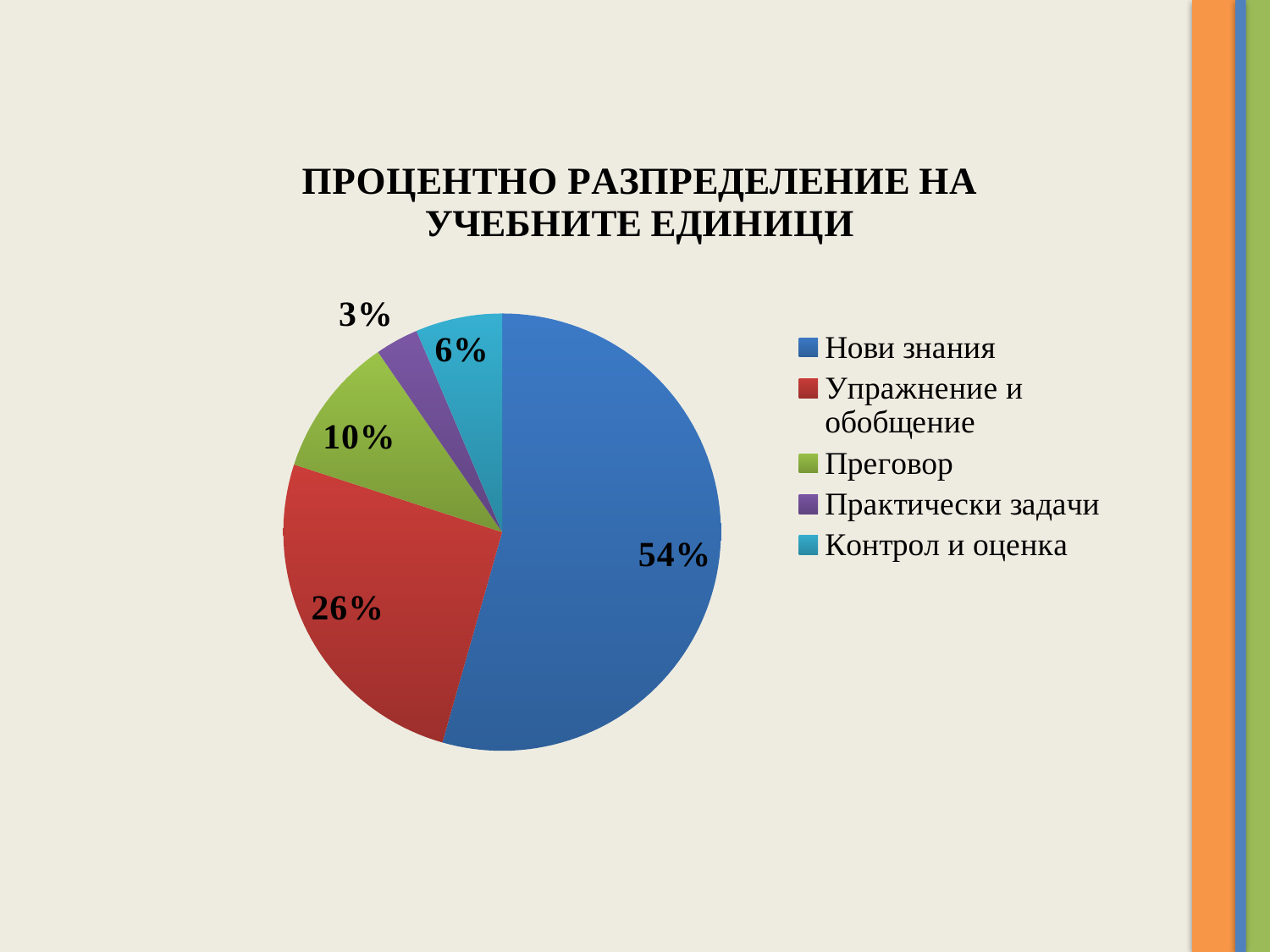
Which category has the largest share of the pie? Нови знания What is the difference in percentage points between 'Нови знания' and 'Упражнение и обобщение'? 28 What percentage of the pie is 'Упражнение и обобщение'? 26% Which is larger, the share for 'Преговор' or the share for 'Контрол и оценка'? Преговор How many categories does the legend list? 5 What percentage of the pie is 'Нови знания'? 54% What percentage of the pie is 'Контрол и оценка'? 6% Which category has the smallest share of the pie? Практически задачи What percentage of the pie is 'Практически задачи'? 3% What type of chart is shown on the slide? Pie chart What is the title of the chart? ПРОЦЕНТНО РАЗПРЕДЕЛЕНИЕ НА УЧЕБНИТЕ ЕДИНИЦИ What percentage of the pie is 'Преговор'? 10%